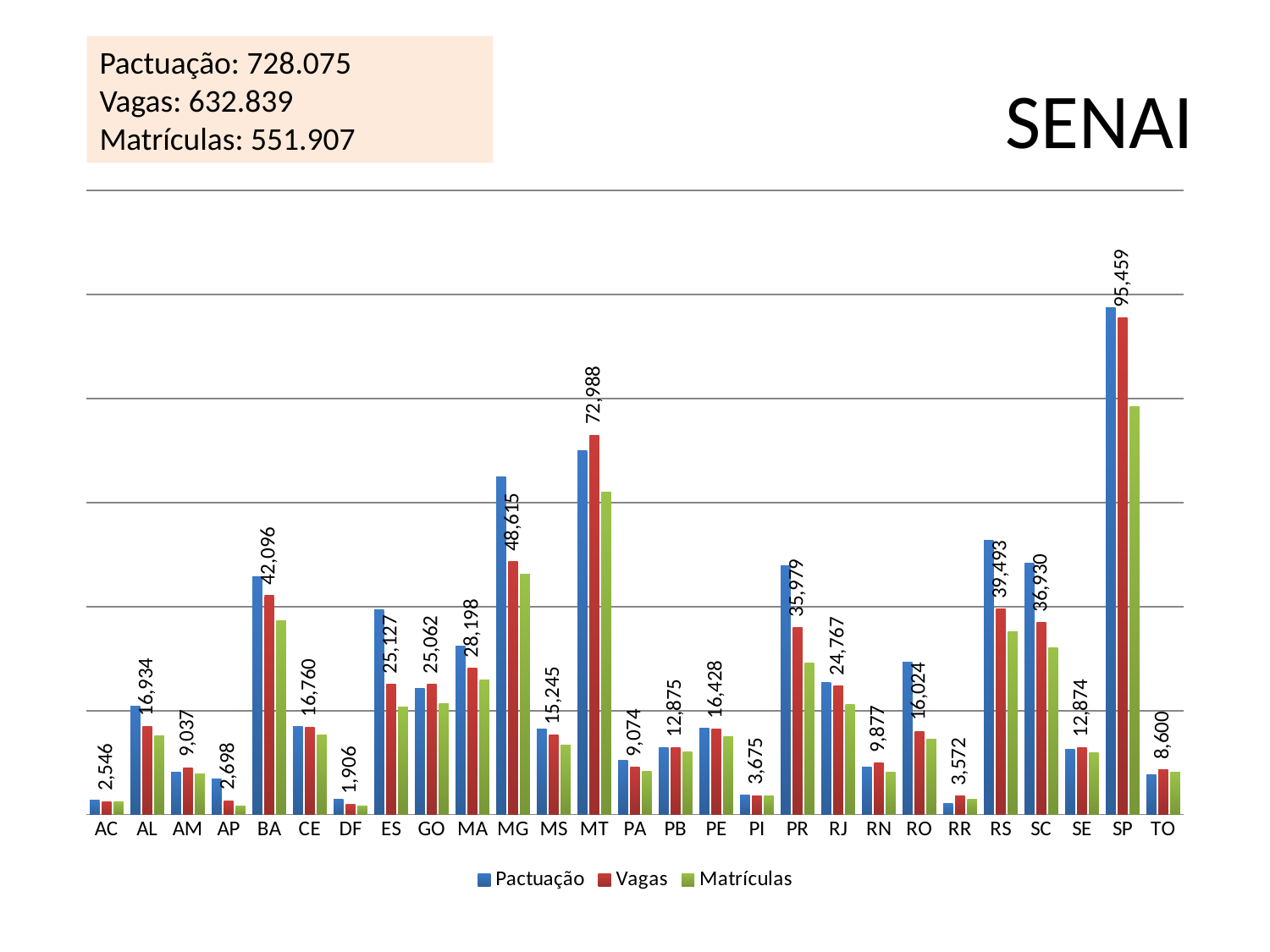
How many series does the legend list? 3 Which state has the highest Pactuação value? SP What type of chart is shown on the slide? Bar chart How many states are shown on the x axis? 27 Which state has the lowest Pactuação value? RR For MT, which is larger, the Pactuação bar or the Vagas bar? Vagas Which has the larger Pactuação value, PR or RS? RS